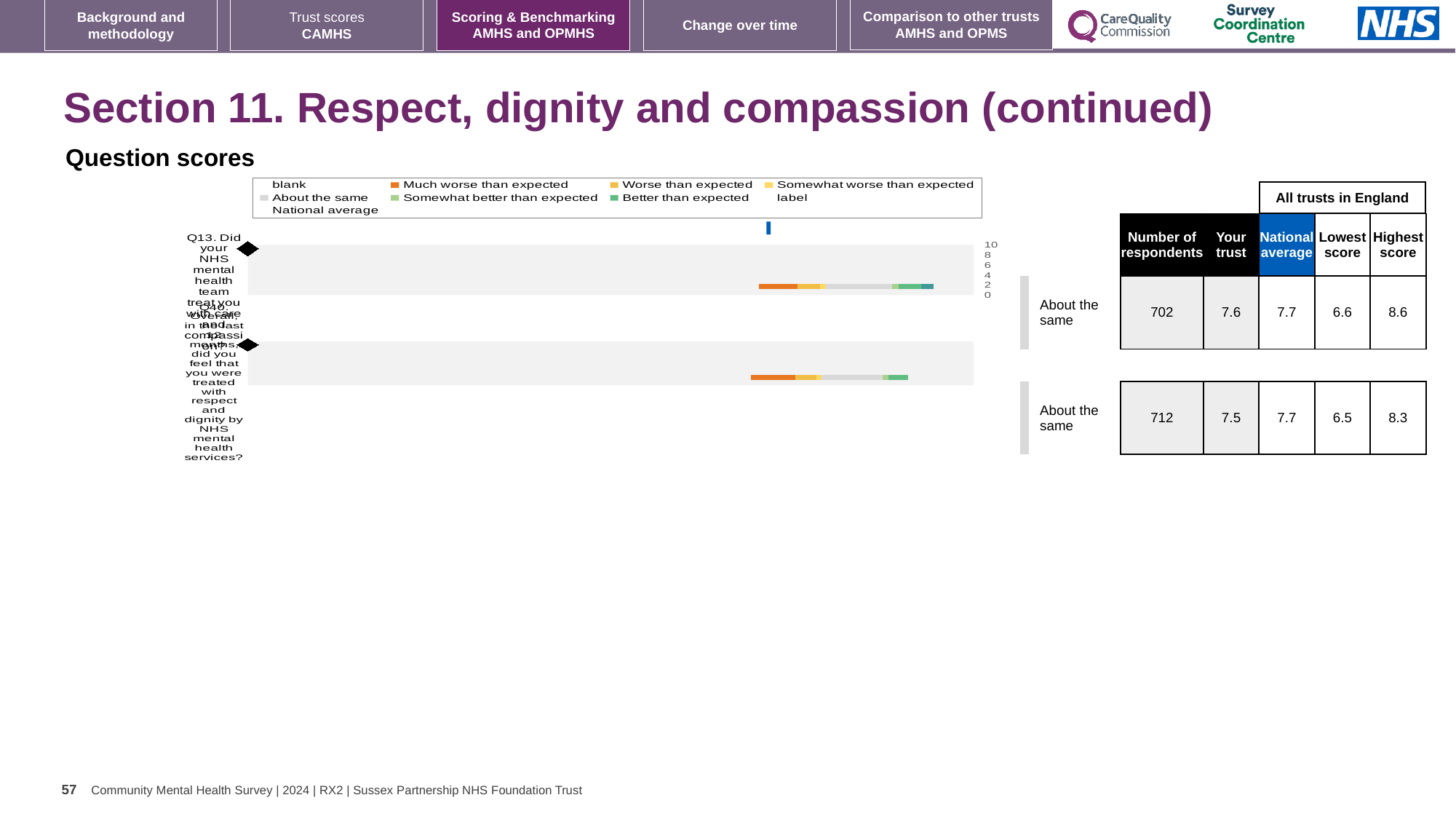
In the chart legend, which colour represents 'Better than expected'? green What kind of chart is shown under 'Question scores'? bar chart What is the national average score shown for the top question bar? 7.7 For the top question bar, what is the difference between the highest score (8.6) and the lowest score (6.6)? 2.0 What is the highest score across all trusts in England for the bottom question bar? 8.3 How many question bars are plotted in the chart? 2 In the chart legend, which colour represents 'Much worse than expected'? orange What benchmark category is shown beside both question bars? About the same What is the difference in number of respondents between the bottom question bar (712) and the top question bar (702)? 10 What is the 'Your trust' score for the bottom question bar (712 respondents)? 7.5 For the top question bar, which is larger: the 'Your trust' score or the national average? national average What is the 'Your trust' score for the top question bar (702 respondents)? 7.6